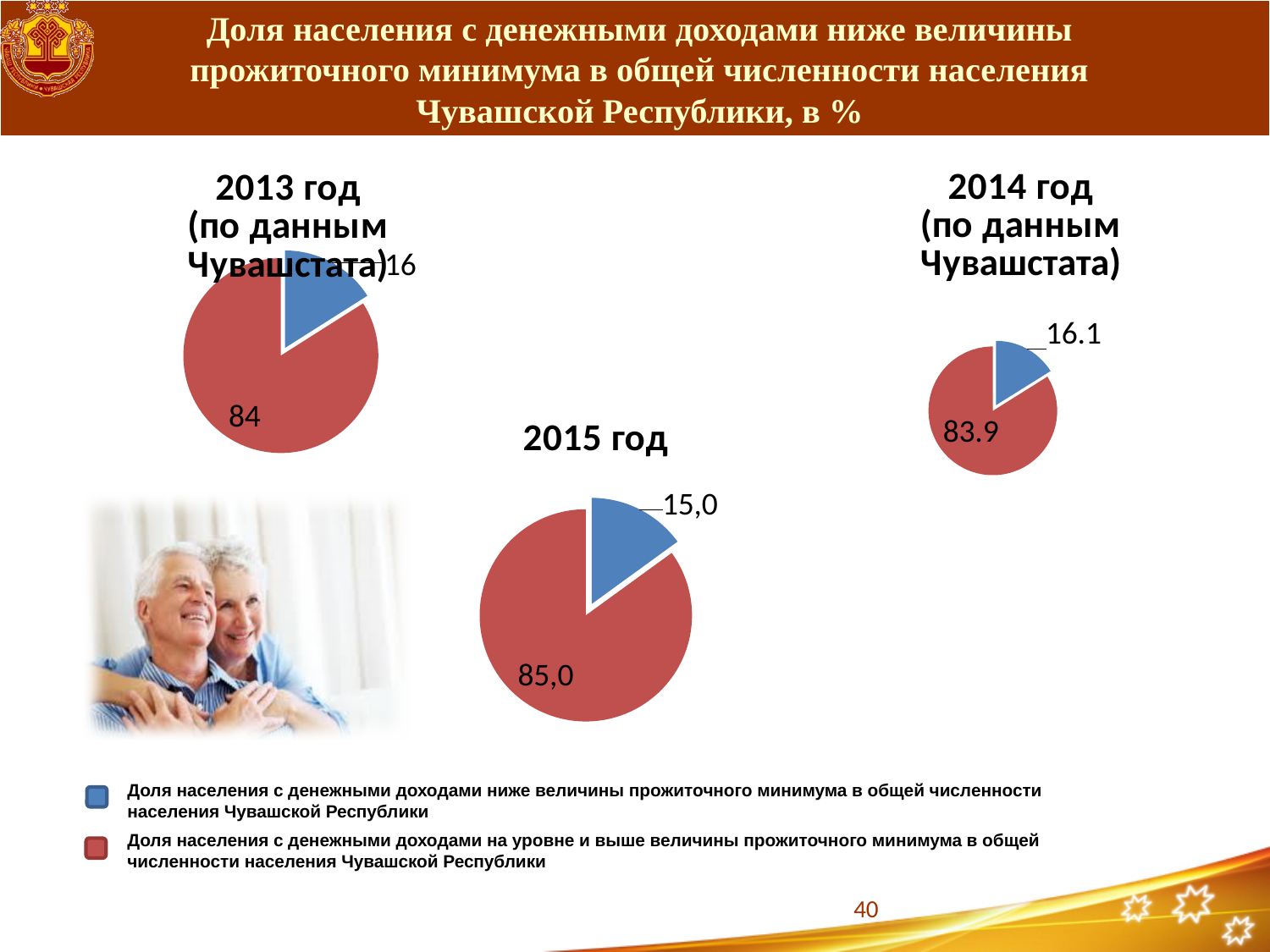
In the 2015 год pie chart, which slice is larger, the blue one or the red one? the red one In the 2015 год pie chart, what is the value of the blue slice? 15,0 Which colour in the legend represents the share of population with incomes below the subsistence minimum? blue How many entries does the legend at the bottom of the slide list? 2 In the 2013 год pie chart, what is the value of the blue slice (share of population with incomes below the subsistence minimum)? 16 How many pie charts are shown on the slide? 3 How many slices does each pie chart on the slide have? 2 In the 2015 год pie chart, what is the value of the red slice? 85,0 What kind of chart is used for the 2013 год data? pie chart In the 2013 год pie chart, what is the value of the red slice (share with incomes at or above the subsistence minimum)? 84 In the 2014 год pie chart, what is the value of the blue slice? 16.1 In the 2014 год pie chart, what is the value of the red slice? 83.9